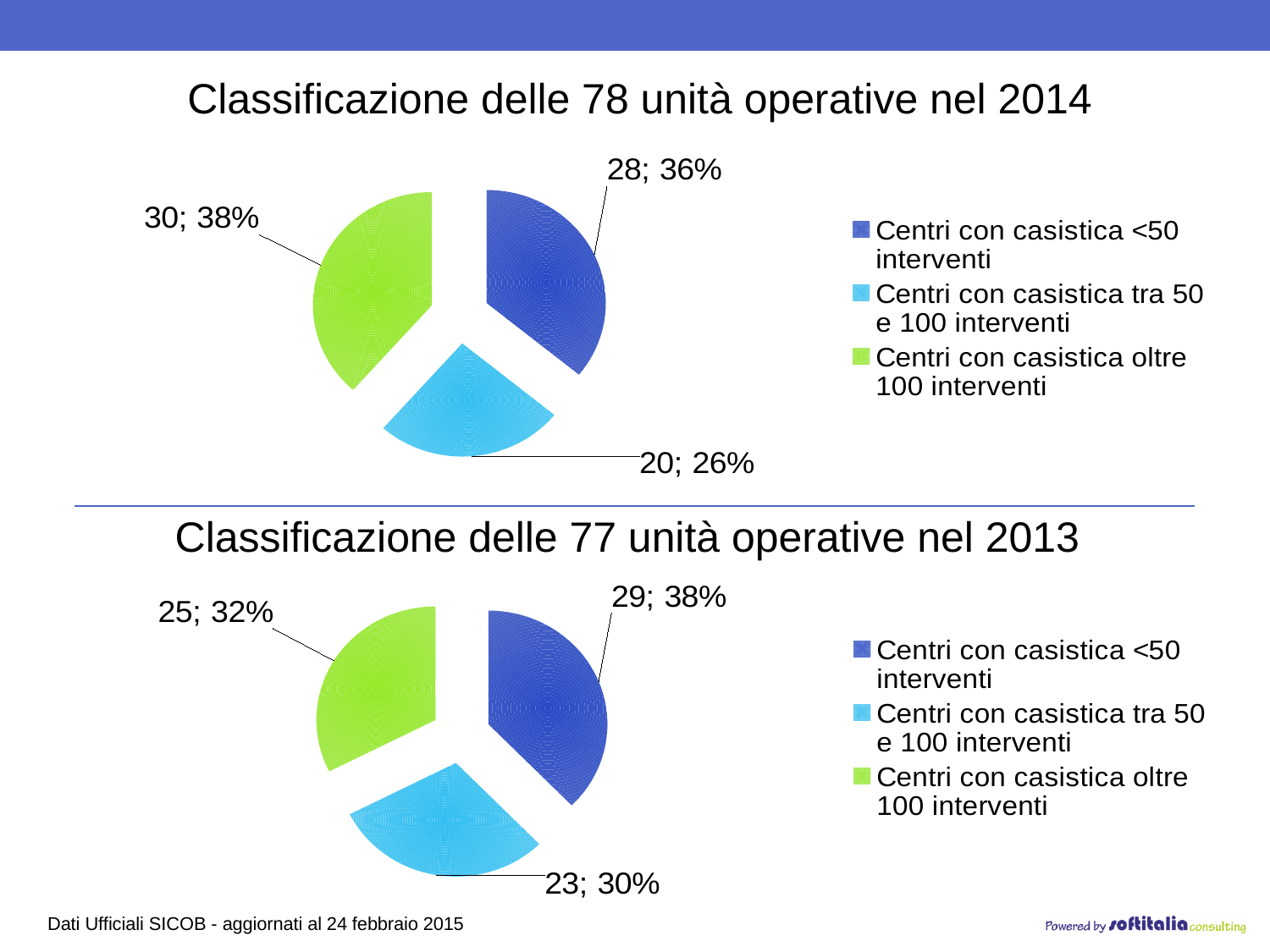
In the 2013 chart (bottom), which is larger: the number of centres with more than 100 interventions or the number with between 50 and 100 interventions? Centri con casistica oltre 100 interventi In the 2014 chart (top), what is the difference between the number of centres with more than 100 interventions and those with between 50 and 100 interventions? 10 In the 2013 chart (bottom), what share of the pie is 'Centri con casistica <50 interventi'? 38% How many categories does the legend of the 2014 chart (top) list? 3 In the 2013 chart (bottom), what colour is the slice for 'Centri con casistica oltre 100 interventi'? Green In the 2014 chart (top), which category has the largest slice? Centri con casistica oltre 100 interventi In the 2013 chart (bottom), which category has the largest slice? Centri con casistica <50 interventi In the 2014 chart (top), which category has the smallest slice? Centri con casistica tra 50 e 100 interventi In the 2014 chart (top), how many centres have a caseload of fewer than 50 interventions? 28 In the 2014 chart (top), what share of the pie is 'Centri con casistica oltre 100 interventi'? 38% What type of chart is used on this slide? Pie chart In the 2013 chart (bottom), how many centres have a caseload between 50 and 100 interventions? 23